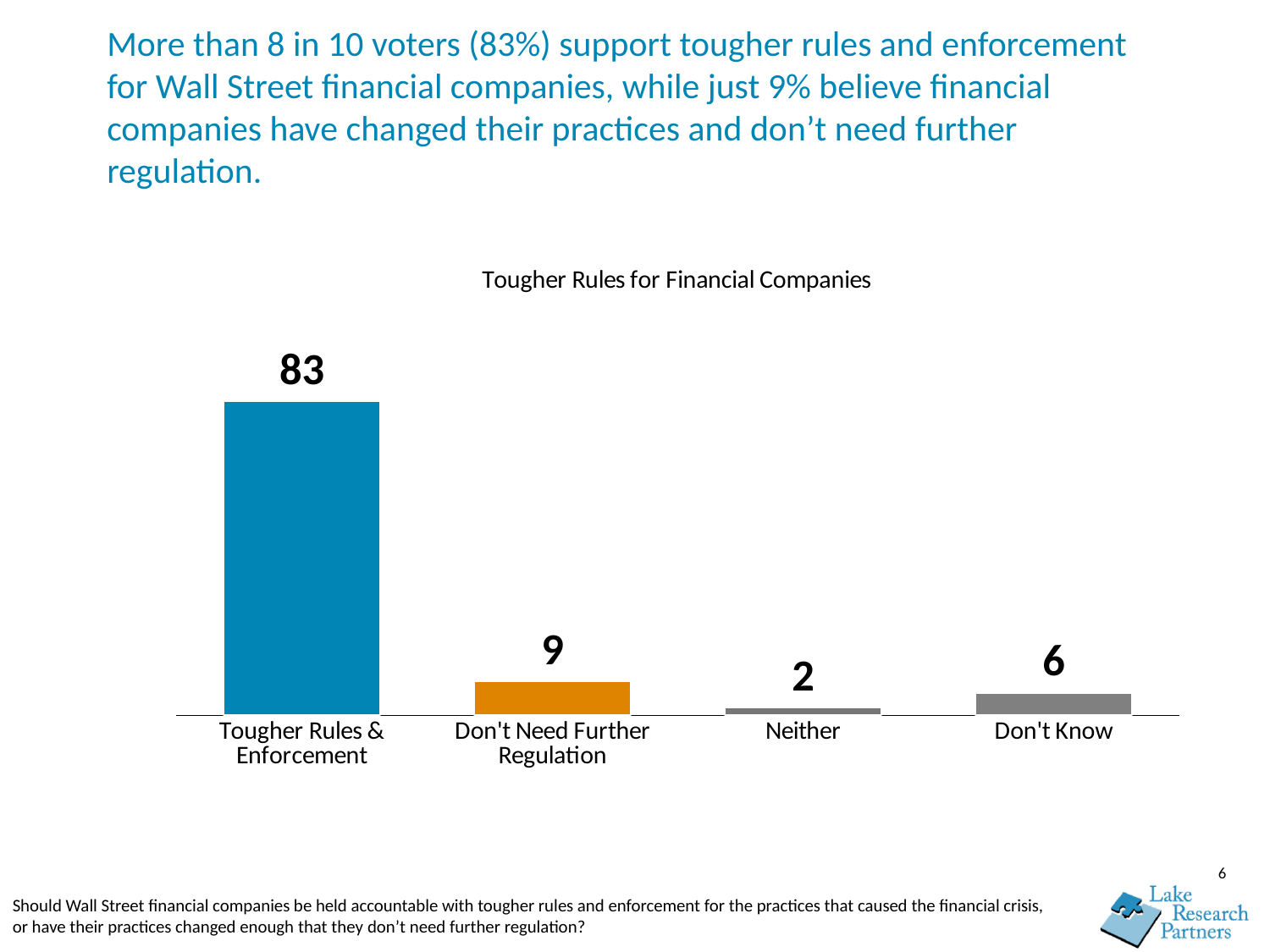
Which category has the lowest value? Neither What is the value for Don't Need Further Regulation? 9 What kind of chart is shown on the slide? Bar chart Which category has the highest value? Tougher Rules & Enforcement Which is larger, the value for Don't Know or the value for Neither? Don't Know What is the value for Neither? 2 What is the value for Don't Know? 6 What is the difference between the values for Don't Need Further Regulation and Don't Know? 3 How many categories are shown in the chart? 4 What is the value for Tougher Rules & Enforcement? 83 What is the difference between the values for Tougher Rules & Enforcement and Don't Need Further Regulation? 74 What is the title of the chart? Tougher Rules for Financial Companies